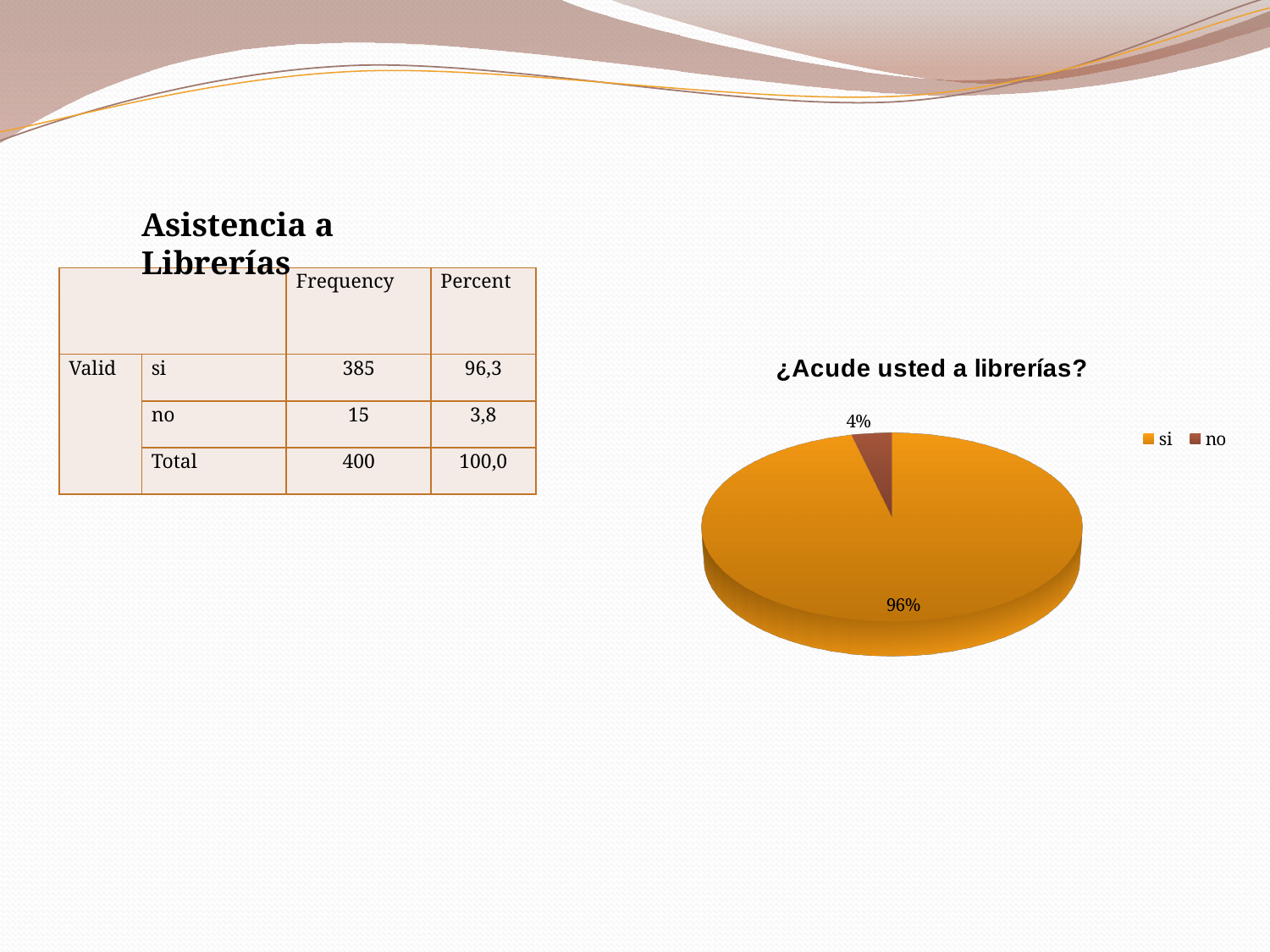
Which slice of the pie chart is the largest? si How many slices does the pie chart have? 2 Which is larger in the pie chart, the "si" slice or the "no" slice? si What is the title of the pie chart? ¿Acude usted a librerías? What is the difference in percentage points between the "si" and "no" slices? 92% How many entries does the legend of the pie chart list? 2 What kind of chart is shown on the slide? pie chart What colour is the "no" slice in the pie chart? brown Which slice of the pie chart is the smallest? no What share of the pie does the "si" slice represent? 96% What share of the pie does the "no" slice represent? 4%